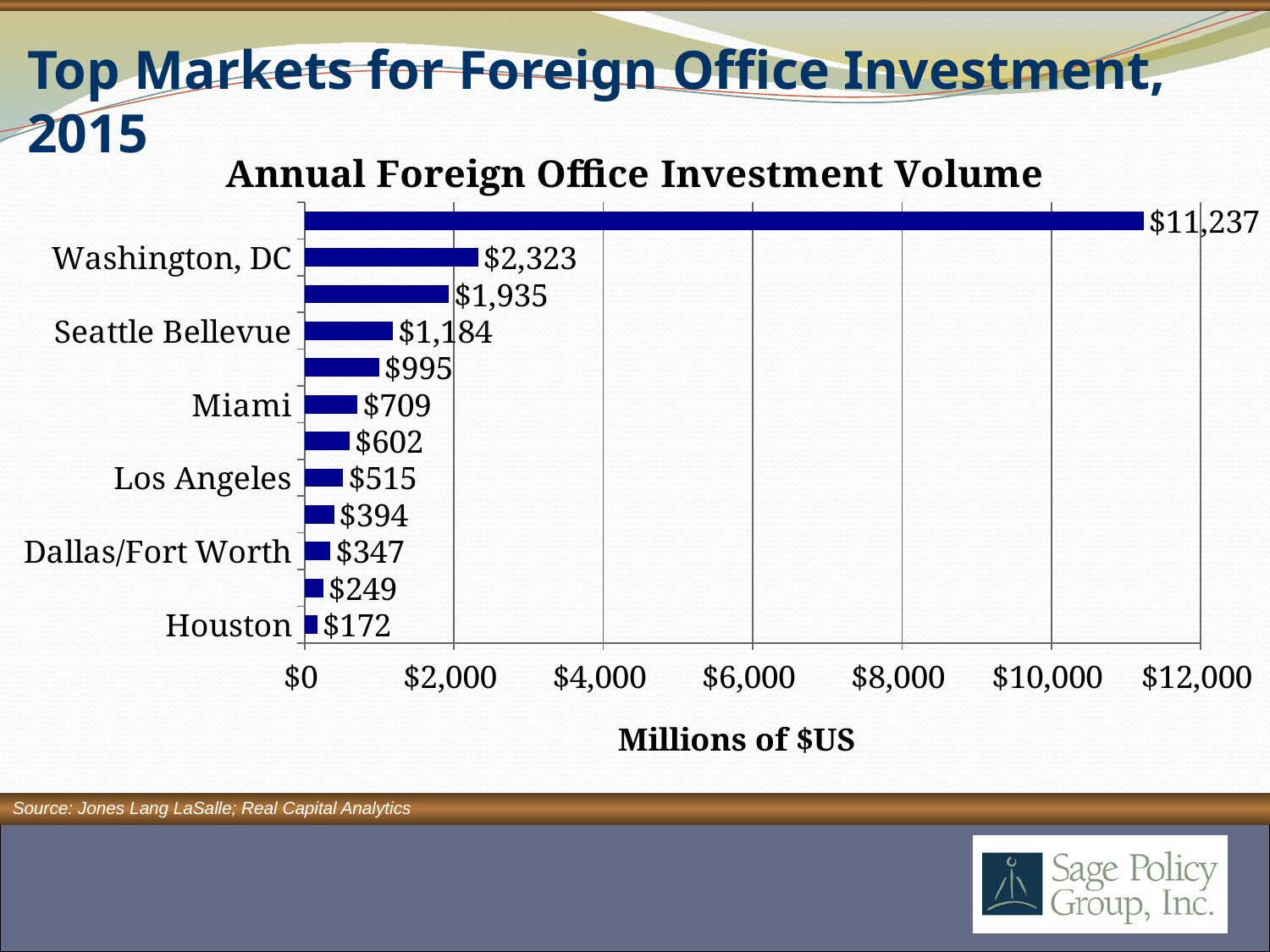
What kind of chart is shown on the slide? Bar chart Which labeled market has the lowest value in the chart? Houston What is the value for Seattle Bellevue? $1,184 What is the value for Los Angeles? $515 What is the value for Dallas/Fort Worth? $347 Which is larger, the value for Miami or the value for Los Angeles? Miami What is the value for Miami? $709 How many bars are plotted in the chart? 12 What unit is given on the x-axis label of the chart? Millions of $US What is the largest value shown on any bar in the chart? $11,237 What is the value for Washington, DC in the Annual Foreign Office Investment Volume chart? $2,323 What is the difference between the values for Washington, DC and Seattle Bellevue? $1,139